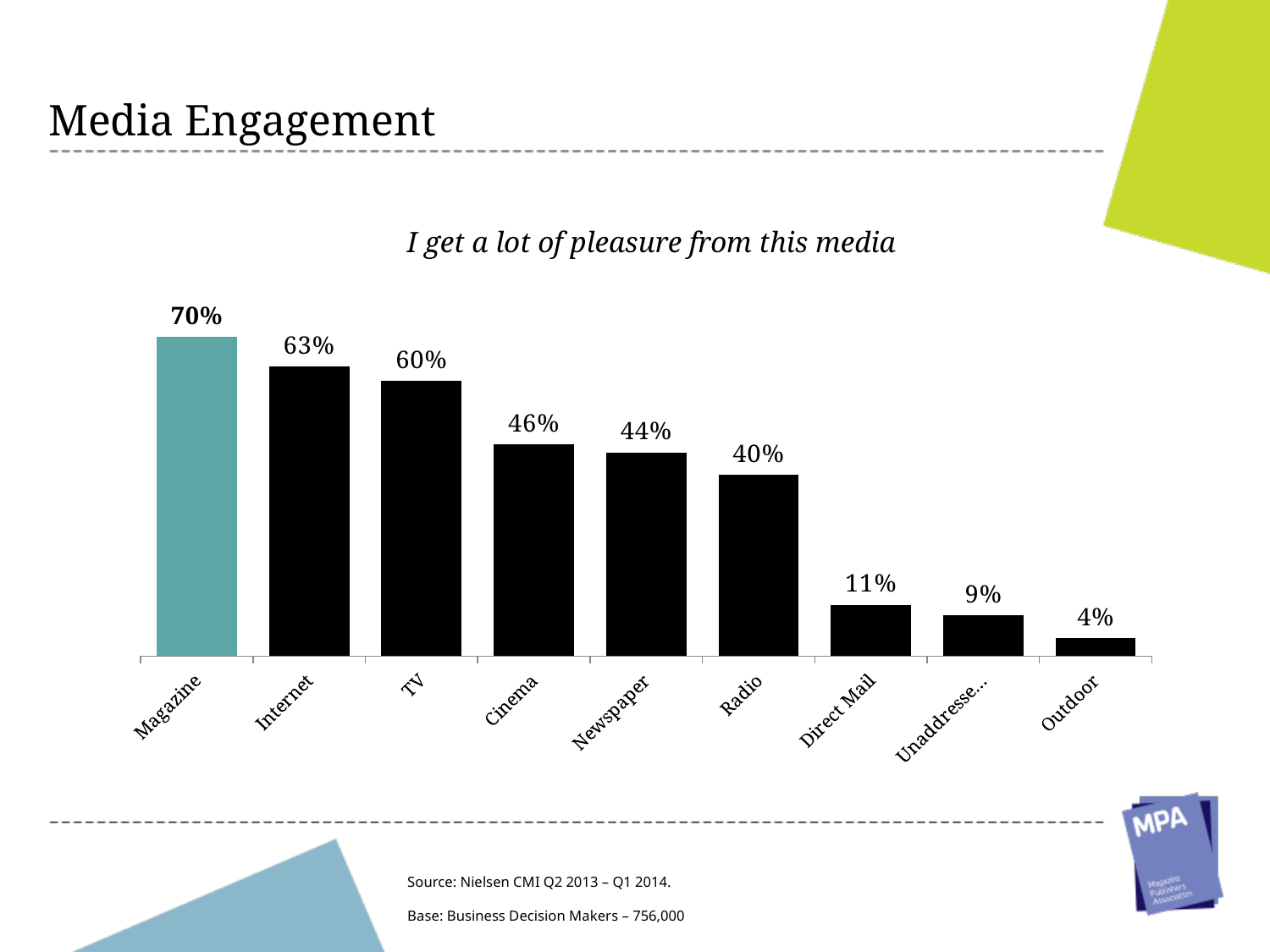
Which media has the lowest value? Outdoor How many media categories are shown in the chart? 9 What is the value for Direct Mail? 11% What kind of chart is shown on the slide? Bar chart What is the value for Cinema? 46% Which is larger, the value for Newspaper or the value for Radio? Newspaper Which media has the highest value? Magazine What is the difference between the values for Magazine and Radio? 30% Do the values rise or fall from left to right along the x axis? Fall Which bar is coloured differently from the others? Magazine What is the value for Magazine? 70% What is the difference between the values for Internet and TV? 3%